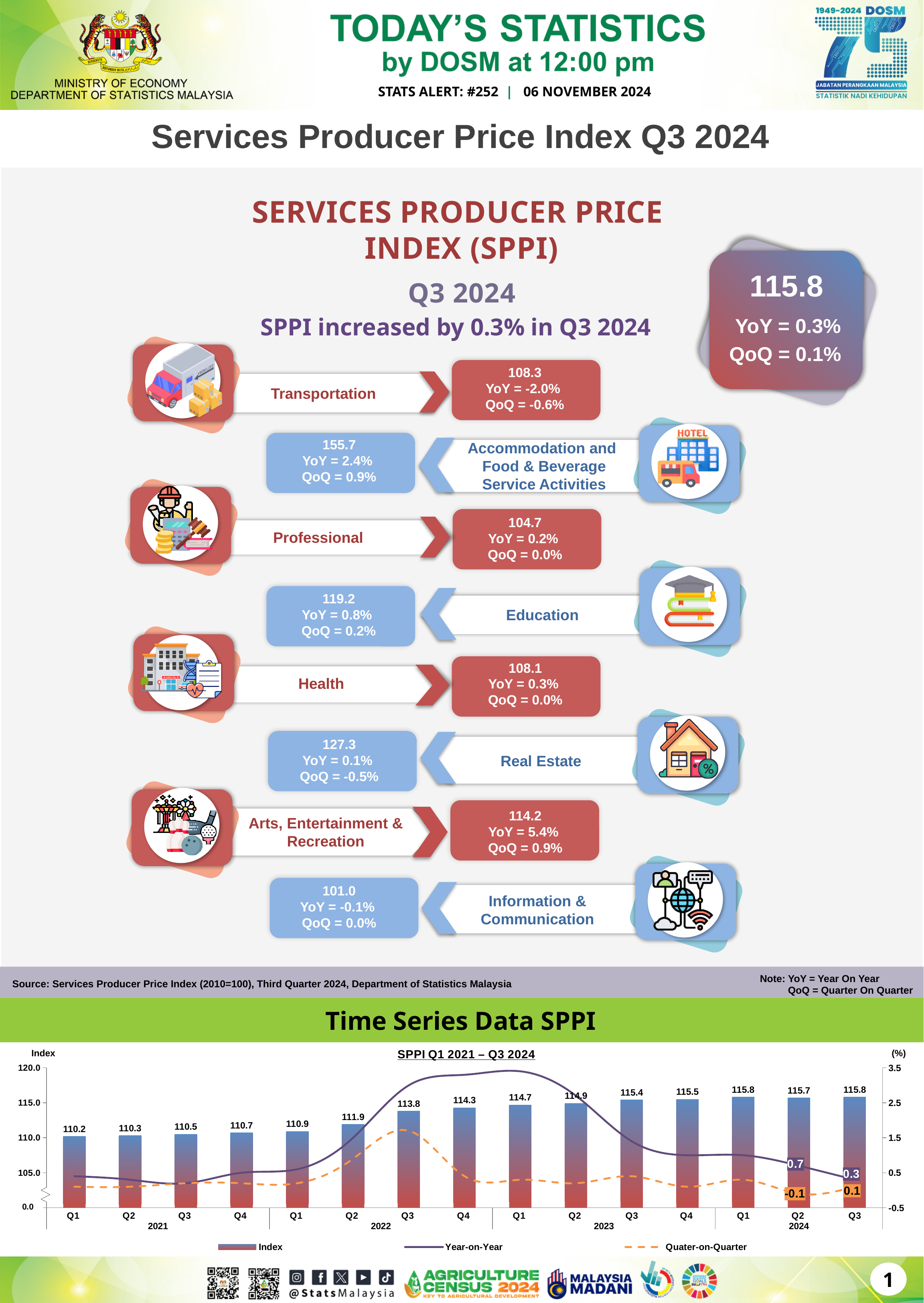
Which quarter has the lowest Index value in the SPPI Q1 2021 – Q3 2024 chart? Q1 2021 What Quarter-on-Quarter value is labelled for Q2 2024 in the SPPI Q1 2021 – Q3 2024 chart? -0.1 Is the Year-on-Year value for Q3 2022 in the SPPI Q1 2021 – Q3 2024 chart greater or less than 2.5? greater What is the Index value for Q3 2022 in the SPPI Q1 2021 – Q3 2024 chart? 113.8 How many series does the legend of the SPPI Q1 2021 – Q3 2024 chart list? 3 Which is larger in the SPPI Q1 2021 – Q3 2024 chart, the Index value for Q4 2023 or for Q1 2024? Q1 2024 What Year-on-Year value is labelled for Q2 2024 in the SPPI Q1 2021 – Q3 2024 chart? 0.7 What is the Index value for Q1 2021 in the SPPI Q1 2021 – Q3 2024 chart? 110.2 What is the difference between the Index values for Q3 2022 and Q2 2022 in the SPPI Q1 2021 – Q3 2024 chart? 1.9 How many quarters are plotted in the SPPI Q1 2021 – Q3 2024 chart? 15 What is the Index value for Q3 2024 in the SPPI Q1 2021 – Q3 2024 chart? 115.8 Does the Index series in the SPPI Q1 2021 – Q3 2024 chart generally rise or fall from Q1 2021 to Q3 2024? rise